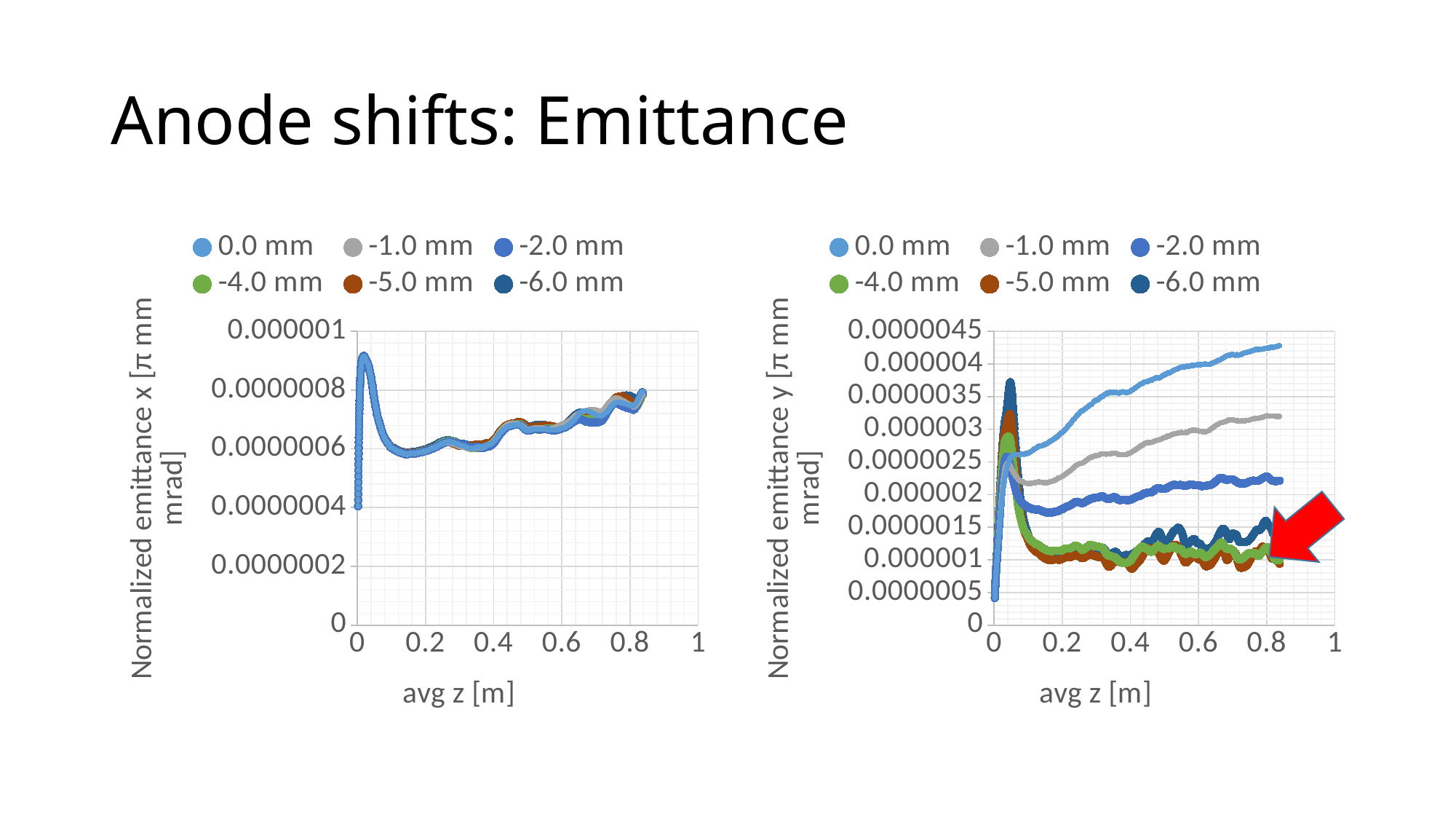
On the right chart (Normalized emittance y), does the 0.0 mm series rise or fall between avg z = 0.2 m and 0.8 m? rise On the right chart (Normalized emittance y), is the value of the 0.0 mm series at avg z = 0.8 m greater or less than 0.000004? greater On the left chart (Normalized emittance x), is the peak value of the curves near avg z = 0.02 m greater or less than 0.0000008? greater On the right chart (Normalized emittance y), which is larger at avg z = 0.8 m: the 0.0 mm series or the -1.0 mm series? 0.0 mm On the left chart (Normalized emittance x), is the value of the curves at avg z = 0.2 m greater or less than 0.0000008? less What kind of chart is the left chart (Normalized emittance x)? line chart What is the x-axis title of the left chart? avg z [m] On the right chart (Normalized emittance y), which series has the highest value at avg z = 0.8 m? 0.0 mm What is the y-axis title of the right chart? Normalized emittance y [π mm mrad] How many series does the legend of the right chart (Normalized emittance y) list? 6